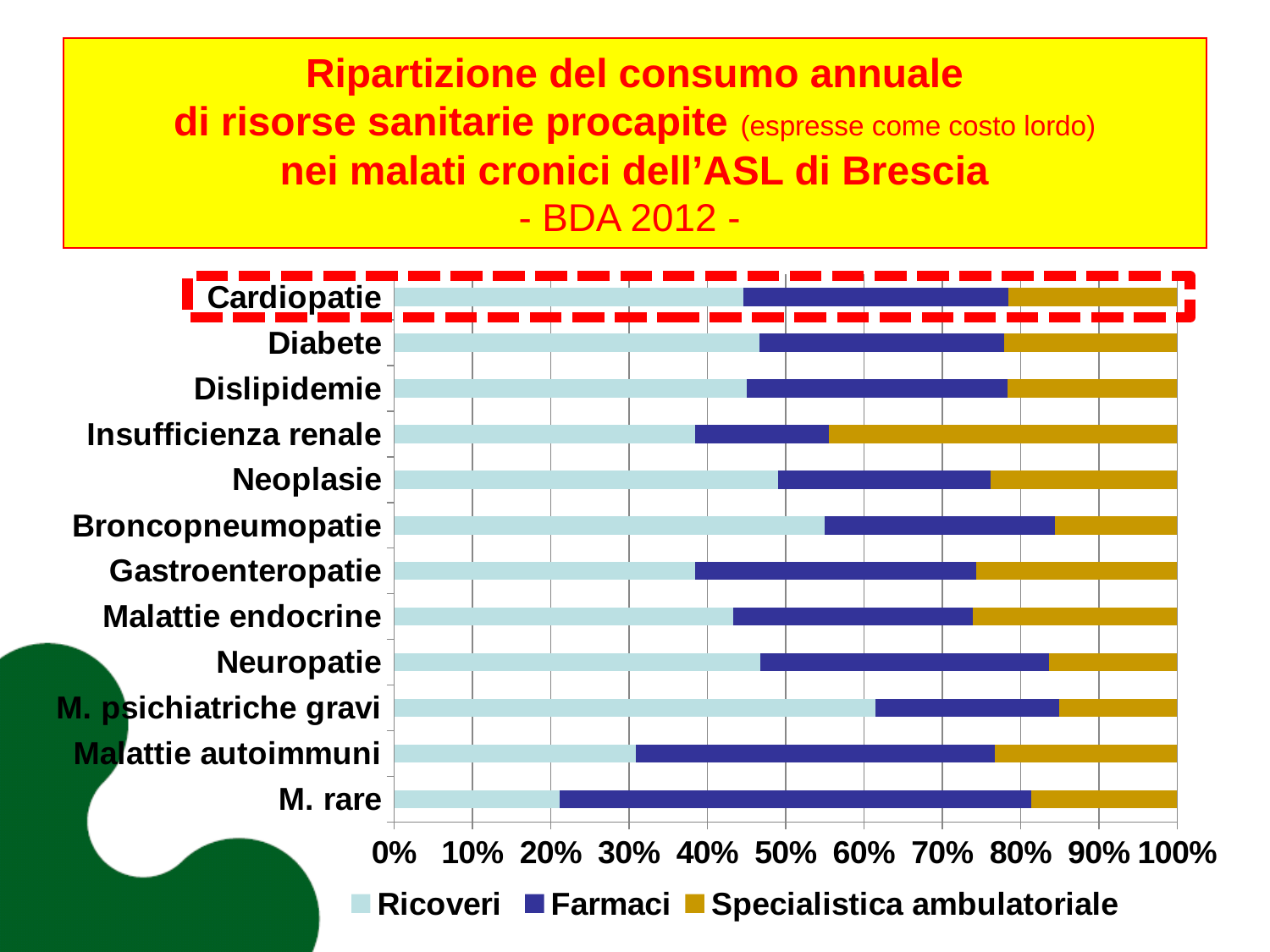
How many series does the legend list? 3 What is the total of the stacked bar for Diabete? 100% What kind of chart is shown on the slide? bar chart Is the Ricoveri share for M. psichiatriche gravi greater or less than 50%? greater How many disease categories are plotted on the chart? 12 Which category has the largest Ricoveri share? M. psichiatriche gravi Which category has the largest Specialistica ambulatoriale share? Insufficienza renale Which category has the largest Farmaci share? M. rare Which has the larger Ricoveri share, Broncopneumopatie or Malattie autoimmuni? Broncopneumopatie Which category is highlighted with a red dashed box? Cardiopatie Is the Ricoveri share for M. rare greater or less than 30%? less Which category has the smallest Ricoveri share? M. rare